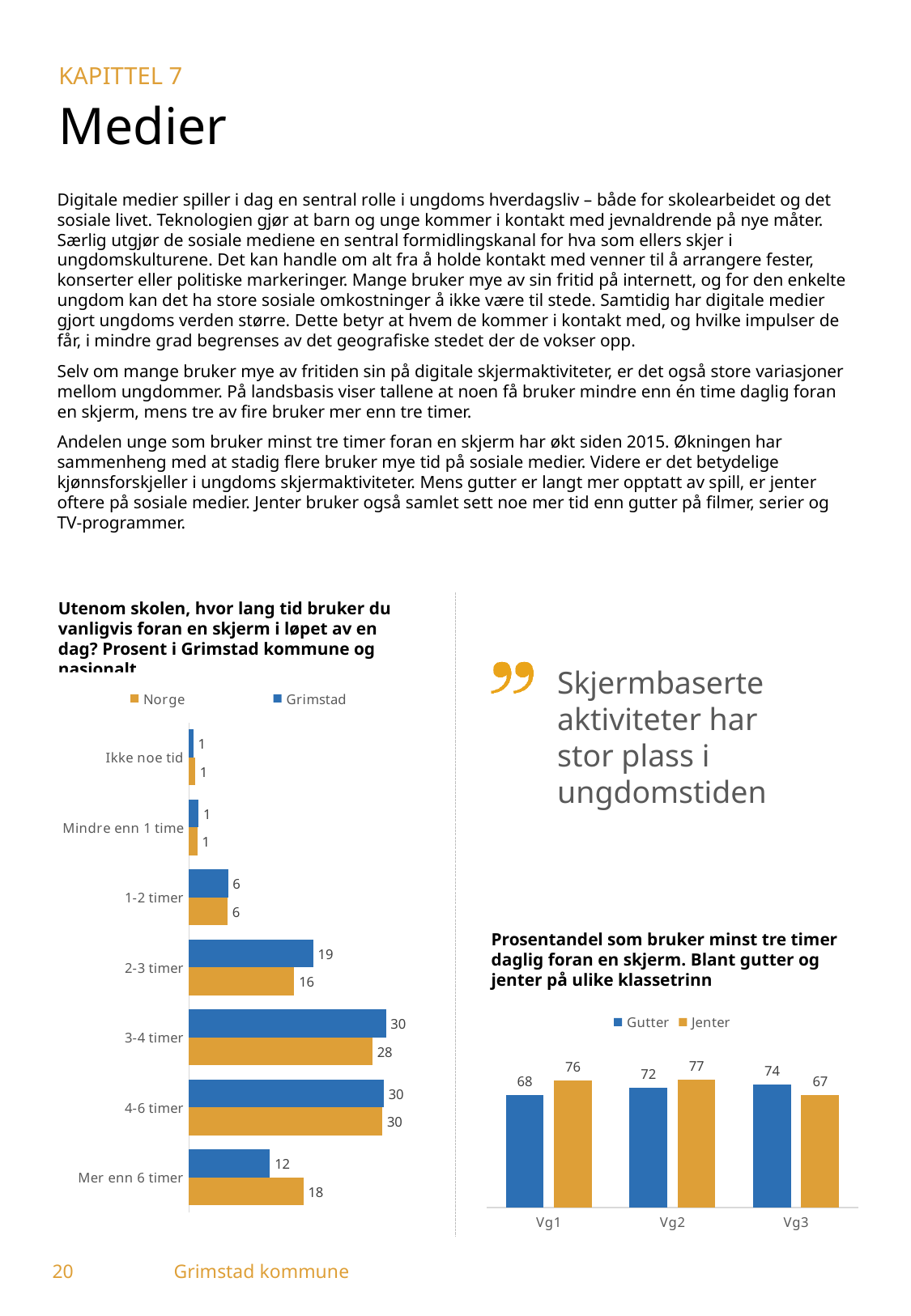
In the chart 'Utenom skolen, hvor lang tid bruker du vanligvis foran en skjerm i løpet av en dag?', which is larger for '3-4 timer', Grimstad or Norge? Grimstad In the chart 'Prosentandel som bruker minst tre timer daglig foran en skjerm', which class level has the highest value for Jenter? Vg2 In the chart 'Prosentandel som bruker minst tre timer daglig foran en skjerm', what is the value for Gutter at Vg2? 72 In the chart 'Prosentandel som bruker minst tre timer daglig foran en skjerm', how many series does the legend list? 2 In the chart 'Prosentandel som bruker minst tre timer daglig foran en skjerm', what is the difference between Jenter and Gutter at Vg1? 8 In the chart 'Utenom skolen, hvor lang tid bruker du vanligvis foran en skjerm i løpet av en dag?', what is the Grimstad value for '2-3 timer'? 19 In the chart 'Utenom skolen, hvor lang tid bruker du vanligvis foran en skjerm i løpet av en dag?', what is the difference between the Norge and Grimstad values for 'Mer enn 6 timer'? 6 In the chart 'Utenom skolen, hvor lang tid bruker du vanligvis foran en skjerm i løpet av en dag?', how many categories are shown on the axis? 7 In the chart 'Prosentandel som bruker minst tre timer daglig foran en skjerm', which is larger at Vg3, Gutter or Jenter? Gutter In the chart 'Prosentandel som bruker minst tre timer daglig foran en skjerm', what is the value for Jenter at Vg3? 67 In the chart 'Utenom skolen, hvor lang tid bruker du vanligvis foran en skjerm i løpet av en dag?', what is the Norge value for 'Mer enn 6 timer'? 18 What kind of chart is the chart 'Utenom skolen, hvor lang tid bruker du vanligvis foran en skjerm i løpet av en dag?'? Bar chart